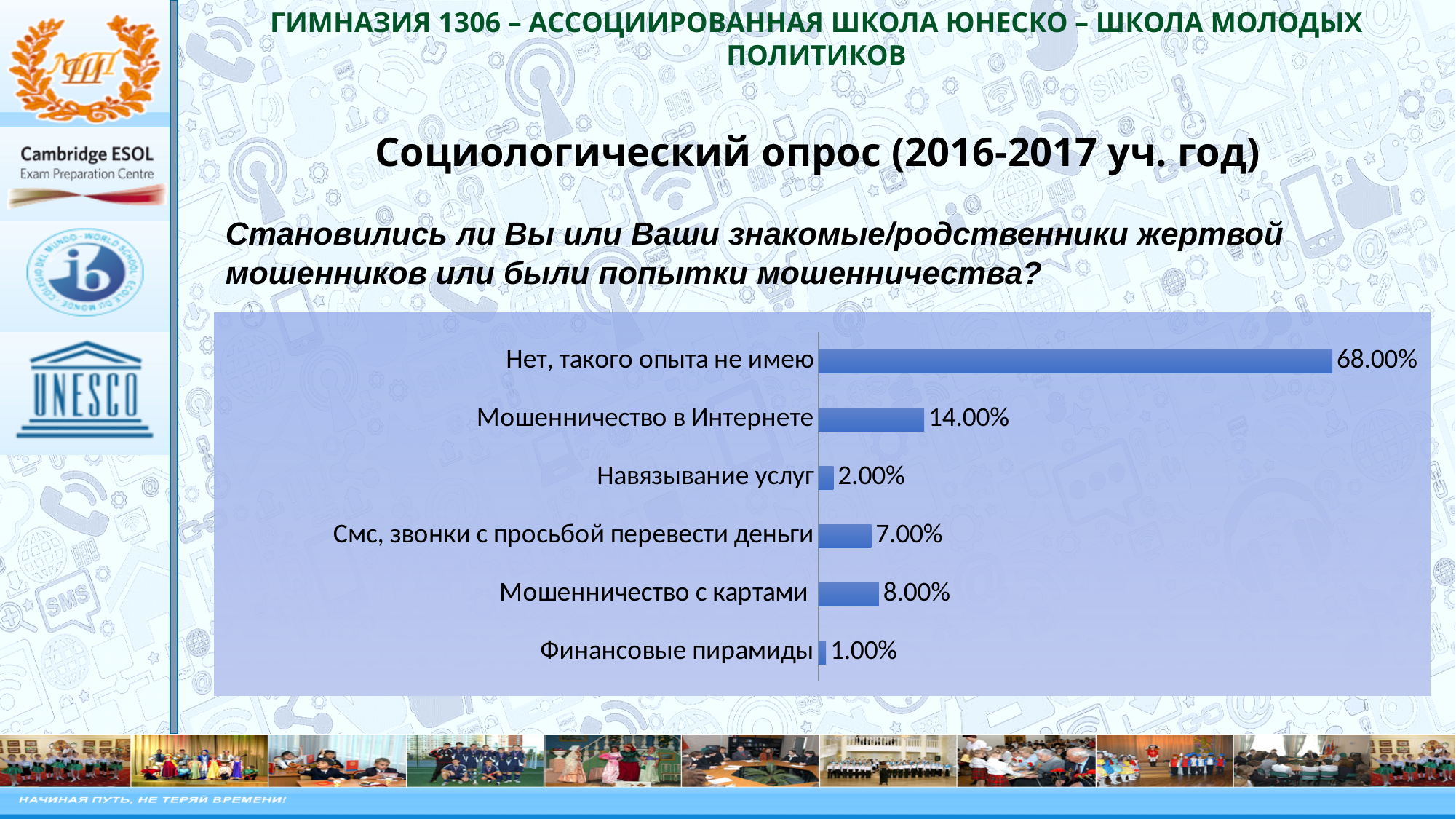
What is the value for "Нет, такого опыта не имею"? 68.00% Which category has the highest value? Нет, такого опыта не имею Which category has the lowest value? Финансовые пирамиды What is the value for "Навязывание услуг"? 2.00% What is the value for "Мошенничество с картами"? 8.00% Which is larger, the value for "Мошенничество с картами" or for "Смс, звонки с просьбой перевести деньги"? Мошенничество с картами What is the difference between the values for "Мошенничество с картами" and "Финансовые пирамиды"? 7.00% How many categories are shown in the chart? 6 What is the value for "Мошенничество в Интернете"? 14.00% What is the value for "Смс, звонки с просьбой перевести деньги"? 7.00% What kind of chart is shown on the slide? Bar chart What is the difference between the values for "Нет, такого опыта не имею" and "Мошенничество в Интернете"? 54.00%